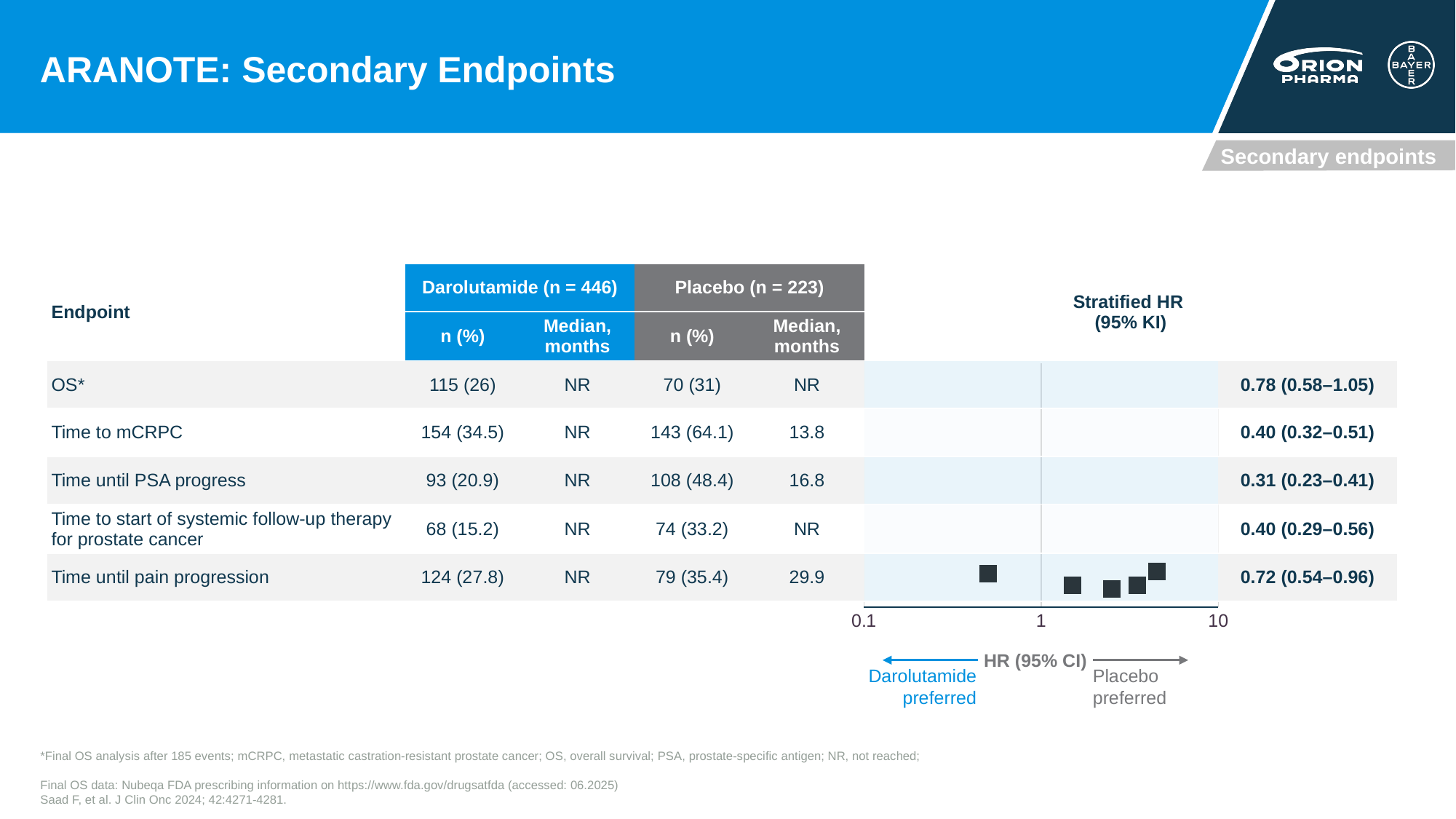
What is the stratified HR (95% CI) shown for OS*? 0.78 (0.58–1.05) Which endpoint has the highest stratified hazard ratio? OS* Which endpoint has a 95% confidence interval whose upper bound exceeds 1? OS* How many endpoints are listed in the forest plot? 5 Is the stratified hazard ratio for Time to mCRPC greater or less than 1? less What is the difference between the stratified hazard ratio for OS* and for Time until PSA progress? 0.47 What tick values are shown on the x axis of the forest plot? 0.1, 1, 10 Which endpoint has the lowest stratified hazard ratio? Time until PSA progress What is the stratified HR (95% CI) shown for Time to mCRPC? 0.40 (0.32–0.51) Which has the larger stratified hazard ratio, OS* or Time until pain progression? OS* According to the arrow labels below the forest plot, which treatment is preferred when the HR is to the left of 1? Darolutamide What is the stratified HR (95% CI) shown for Time until pain progression? 0.72 (0.54–0.96)